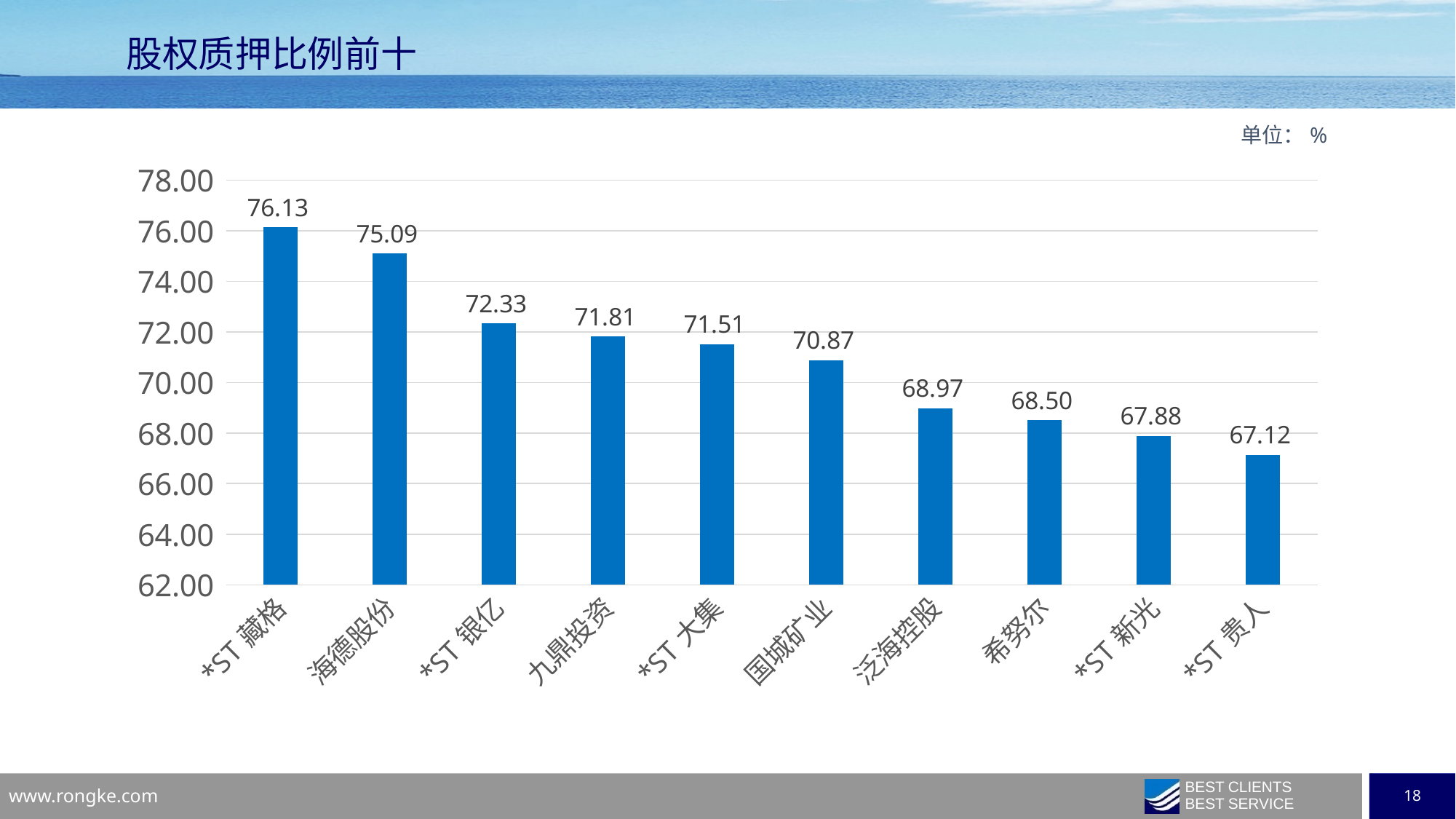
What is the value for 希努尔? 68.50 Which is larger, the value for 九鼎投资 or the value for *ST 大集? 九鼎投资 What is the value for 国城矿业? 70.87 What is the value for *ST 藏格? 76.13 What kind of chart is shown on the slide? bar chart What is the difference between the values for 泛海控股 and *ST 新光? 1.09 How many categories are shown in the chart? 10 What is the difference between the values for *ST 藏格 and 海德股份? 1.04 What unit is indicated for the values in the chart? % Which category has the lowest value? *ST 贵人 Is the value for *ST 银亿 greater or less than 72.00? greater Which category has the highest value? *ST 藏格